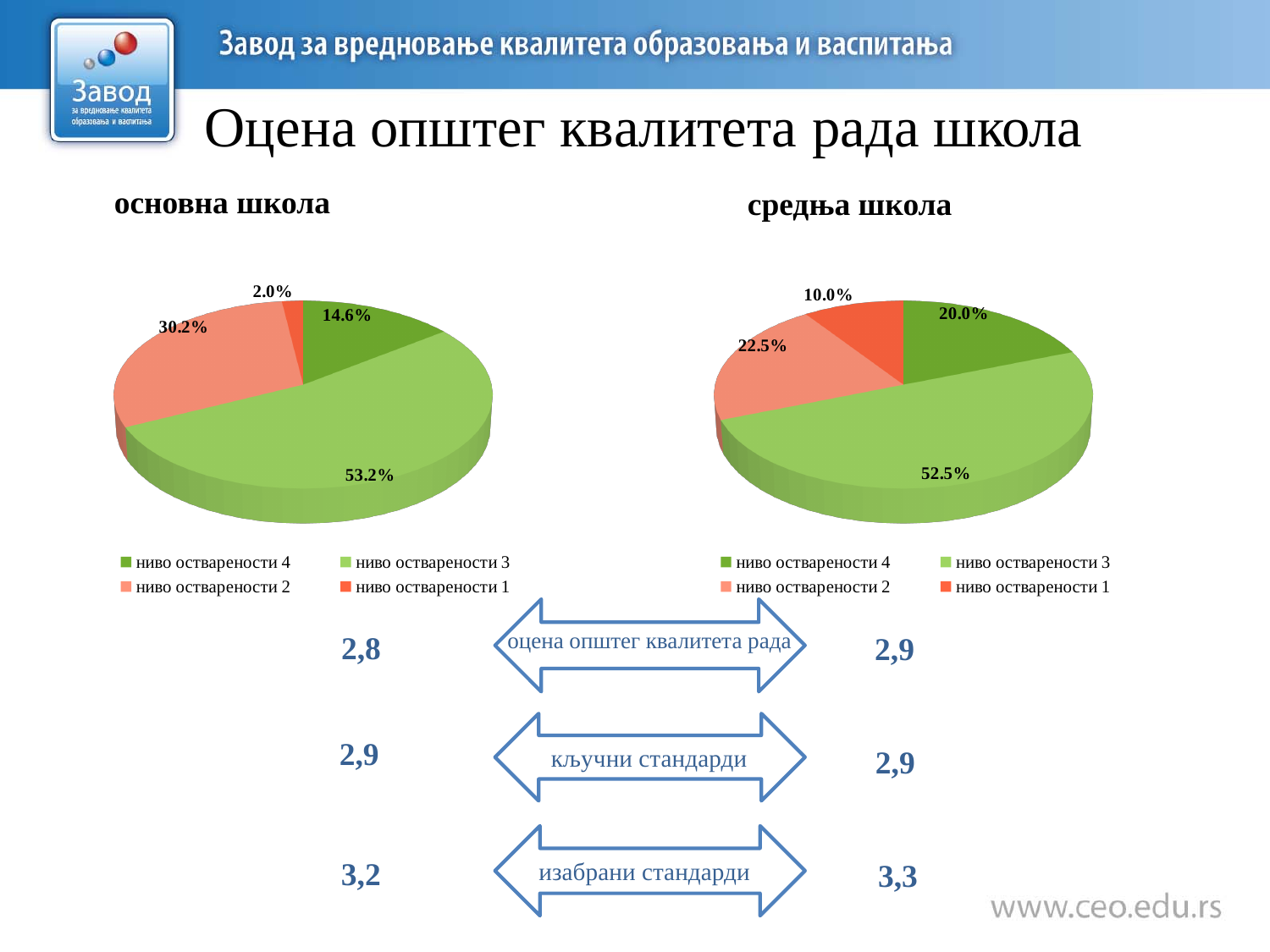
In the "основна школа" pie chart, which category has the smallest share? ниво остварености 1 In the "основна школа" pie chart, which category has the largest share? ниво остварености 3 In the "средња школа" pie chart, what is the value for ниво остварености 1? 10.0% In the "основна школа" pie chart, what is the value for ниво остварености 3? 53.2% What is the difference between the ниво остварености 2 shares in the "основна школа" and "средња школа" pie charts? 7.7% In the "средња школа" pie chart, what is the value for ниво остварености 4? 20.0% What type of chart is used for "основна школа"? pie chart Which is larger: ниво остварености 4 in the "основна школа" chart or ниво остварености 4 in the "средња школа" chart? средња школа How many categories does the "средња школа" pie chart have? 4 In the "основна школа" pie chart, what colour is the slice for ниво остварености 1? red-orange In the "основна школа" pie chart, what is the value for ниво остварености 2? 30.2% In the "средња школа" pie chart, which category has the smallest share? ниво остварености 1